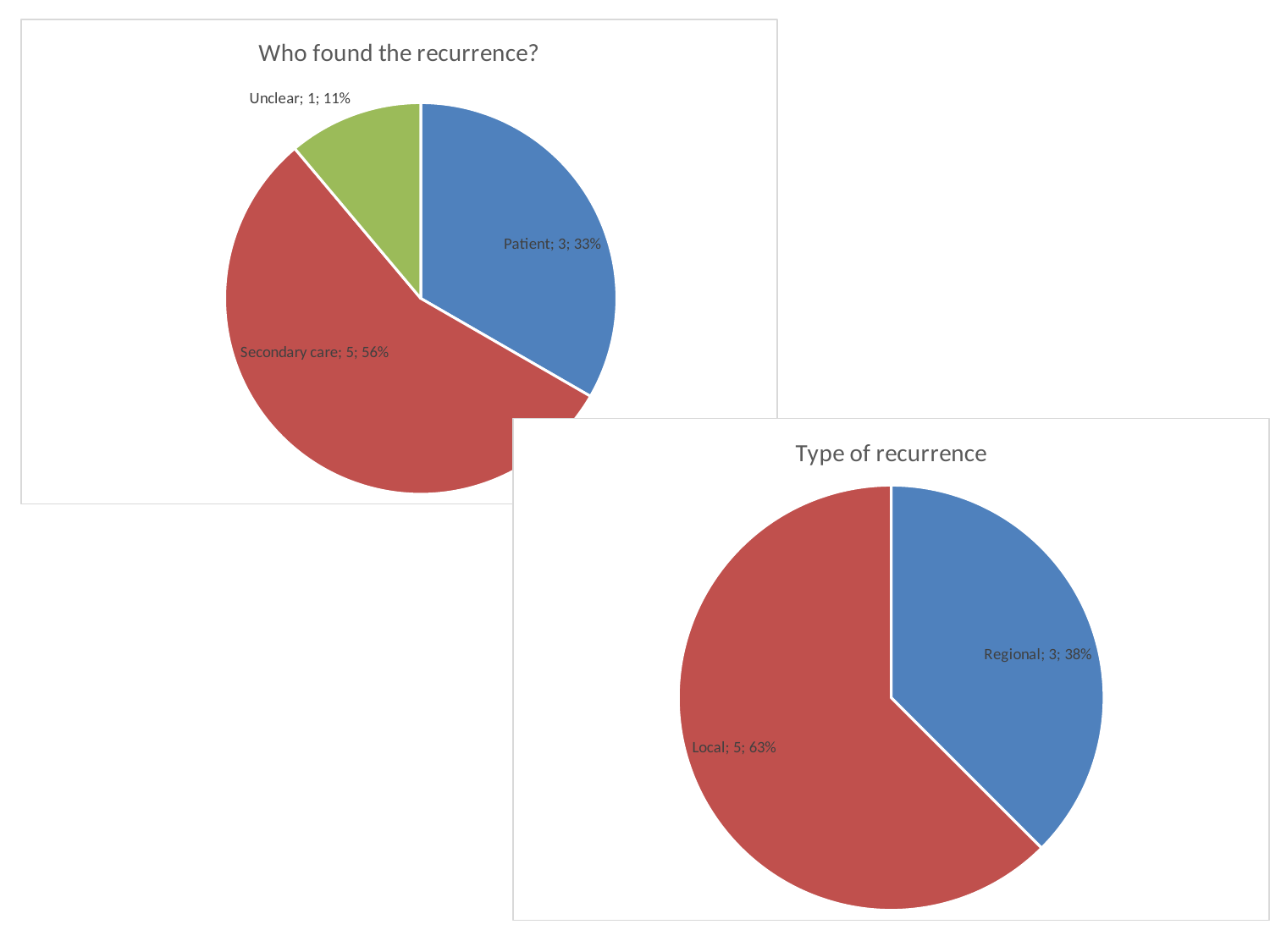
In the 'Who found the recurrence?' chart, which category has the largest slice? Secondary care In the 'Type of recurrence' chart, which is larger, Local or Regional? Local In the 'Type of recurrence' chart, what percentage share does the Regional slice have? 38% In the 'Who found the recurrence?' chart, what is the value for Secondary care? 5 In the 'Who found the recurrence?' chart, what colour is the Unclear slice? Green In the 'Who found the recurrence?' chart, how many categories are shown? 3 In the 'Who found the recurrence?' chart, which category has the smallest slice? Unclear In the 'Who found the recurrence?' chart, what percentage share does the Patient slice have? 33% In the 'Type of recurrence' chart, what is the value for Local? 5 In the 'Who found the recurrence?' chart, what is the difference between the Secondary care and Patient counts? 2 In the 'Type of recurrence' chart, how many categories are shown? 2 What kind of chart is the 'Type of recurrence' chart? Pie chart